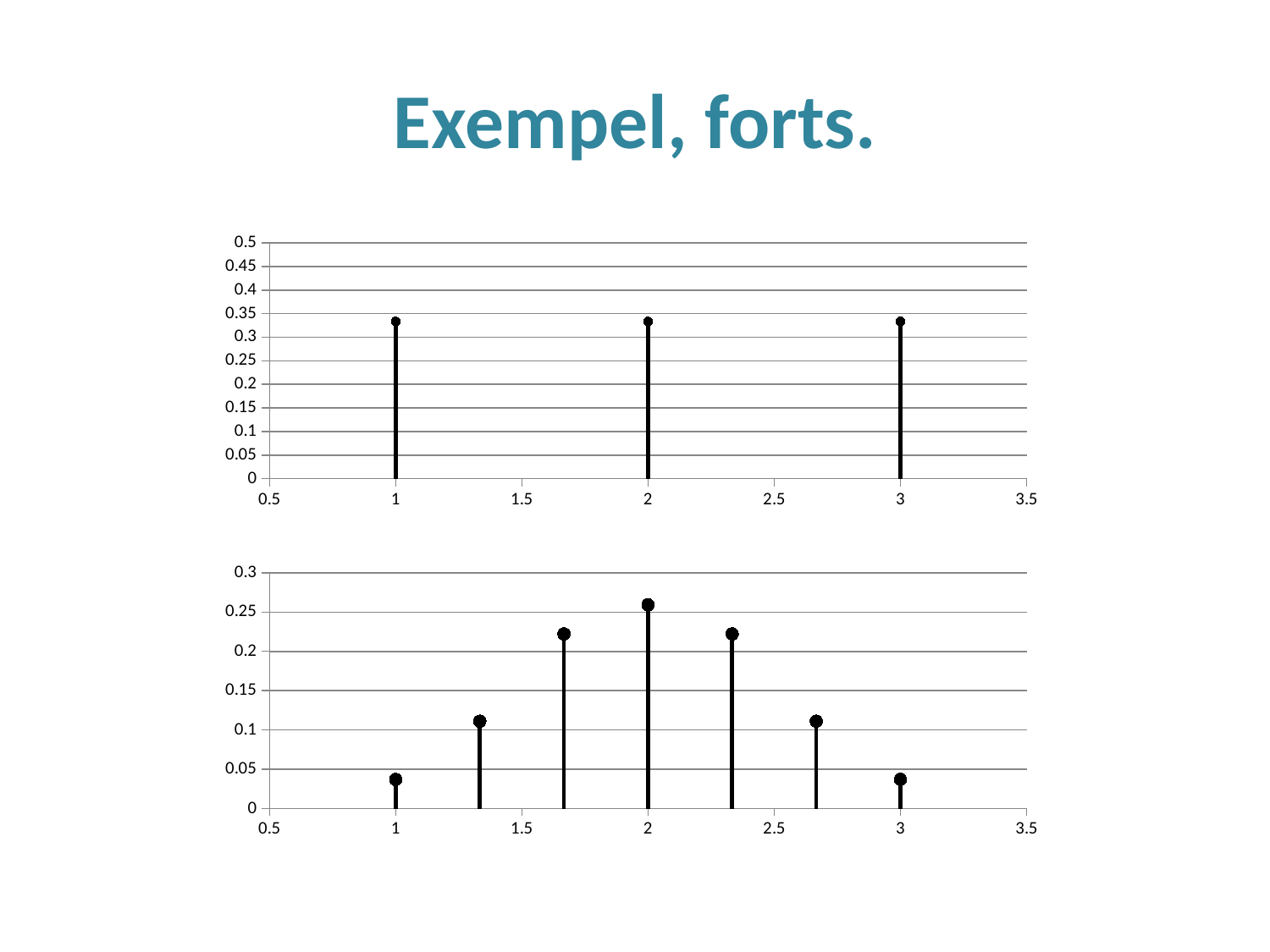
In the bottom chart, is the value at x = 1 greater or less than 0.05? less In the top chart, how many data points are plotted? 3 In the top chart, is the value at x = 2 greater or less than 0.35? less In the bottom chart, do the values rise or fall as x goes from 2 to 3? fall In the top chart, is the value at x = 1 greater or less than 0.3? greater In the bottom chart, at which x value is the plotted value highest? 2 In the bottom chart, how many data points are plotted? 7 How many charts are shown on the slide? 2 In the bottom chart, do the values rise or fall as x goes from 1 to 2? rise What is the title of the slide? Exempel, forts. In the bottom chart, which has the larger value: the point at x = 2 or the point at x = 3? x = 2